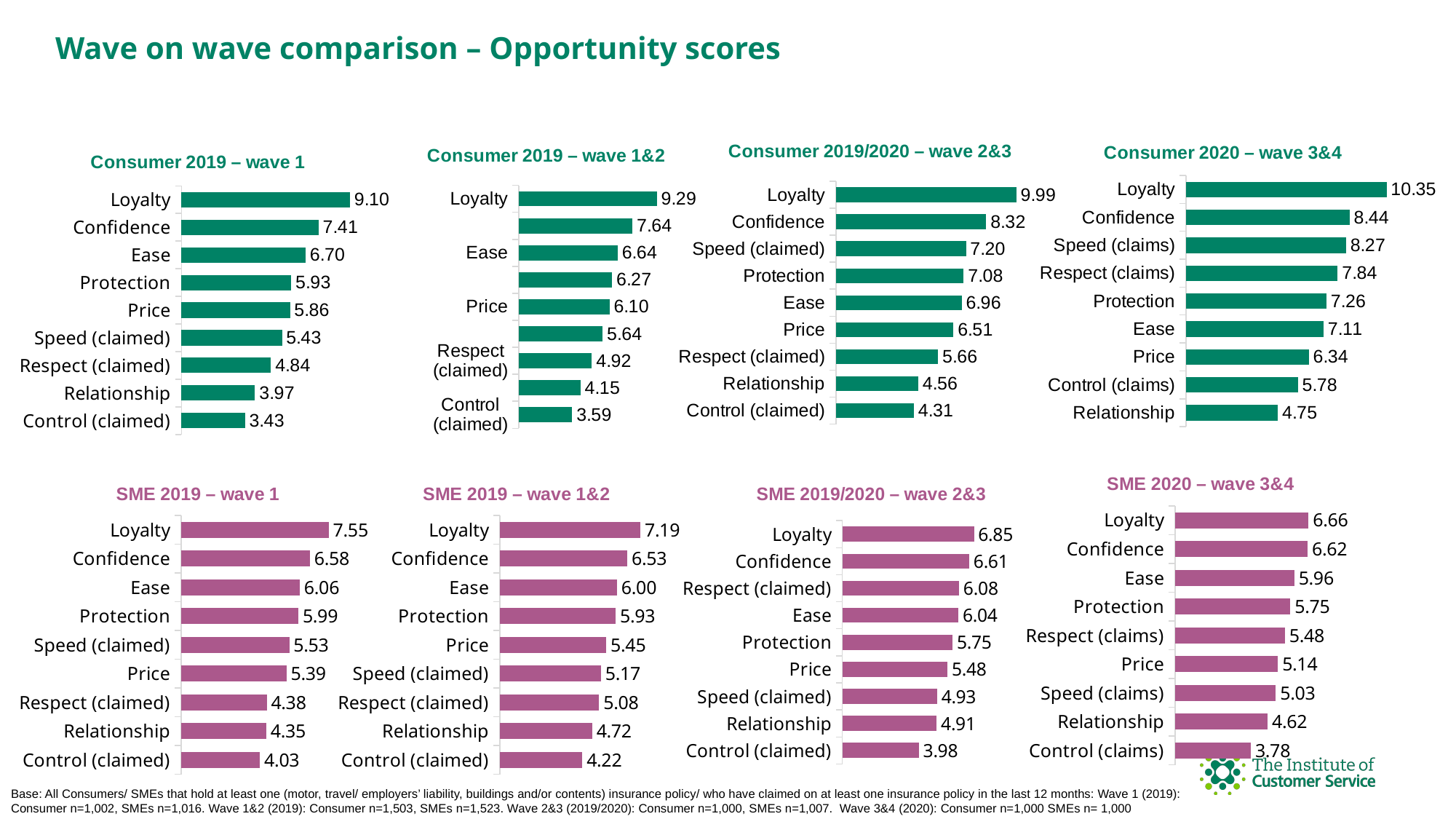
In the 'SME 2020 – wave 3&4' chart, what is the difference between the Loyalty and Control (claims) values? 2.88 In the 'Consumer 2020 – wave 3&4' chart, what is the value for Speed (claims)? 8.27 In the 'Consumer 2020 – wave 3&4' chart, which category has the highest value? Loyalty In the 'SME 2019 – wave 1&2' chart, what is the value for Relationship? 4.72 In the 'SME 2019/2020 – wave 2&3' chart, which category has the lowest value? Control (claimed) In the 'Consumer 2019 – wave 1' chart, what is the value for Loyalty? 9.10 In the 'Consumer 2019/2020 – wave 2&3' chart, what is the difference between the Loyalty and Confidence values? 1.67 How many charts are shown on the slide? 8 What kind of chart is 'Consumer 2019 – wave 1'? Bar chart How many categories are shown in the 'SME 2020 – wave 3&4' chart? 9 In the 'SME 2019 – wave 1' chart, which is larger: Ease or Protection? Ease In the 'Consumer 2019 – wave 1&2' chart, what is the value for Price? 6.10